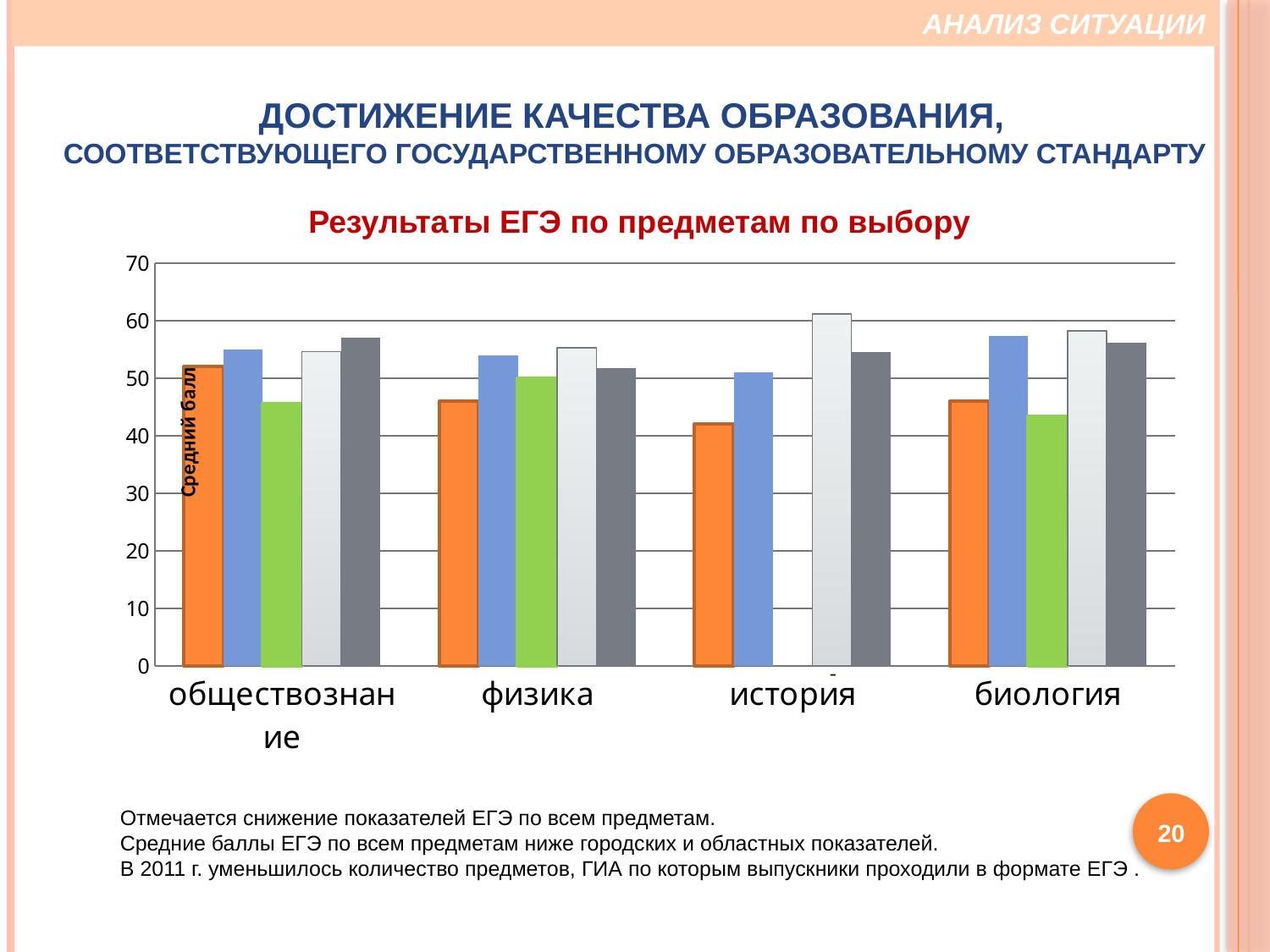
For which subject is the orange bar the lowest? история What is the title of the chart? Результаты ЕГЭ по предметам по выбору Is the orange bar for история greater or less than 50? less What kind of chart is shown on the slide? bar chart Which subject has the highest green bar? физика Is the light grey bar for история greater or less than 60? greater How many subject categories are shown on the x axis? 4 Is the green bar for биология greater or less than 50? less What is the label on the vertical axis? Средний балл How many bars are shown for история? 4 For which subject is the orange bar the highest? обществознание